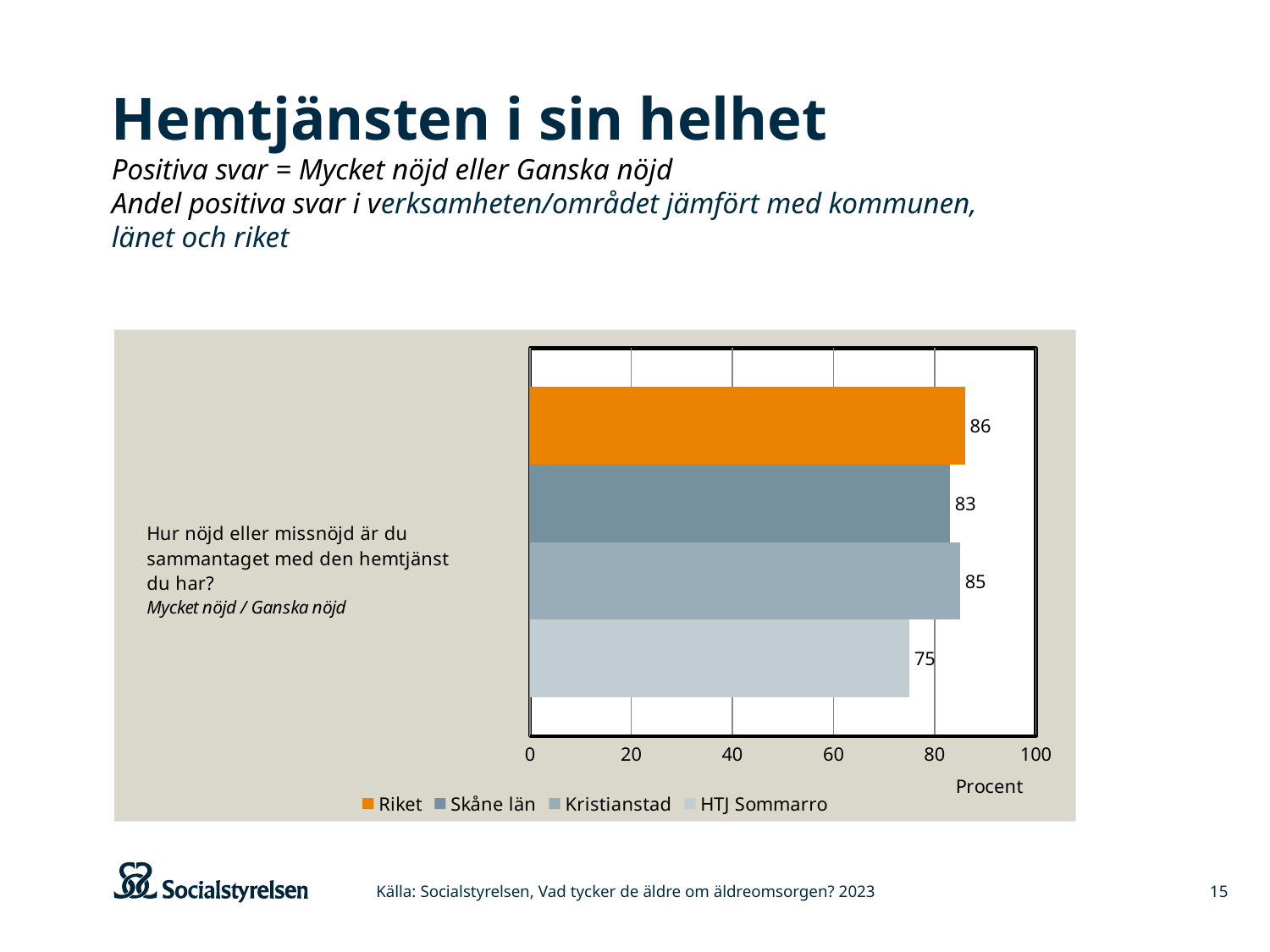
What is the value for Riket? 86 How many series does the legend list? 4 What is the value for HTJ Sommarro? 75 What is the value for Skåne län? 83 Which is larger, the value for Kristianstad or the value for HTJ Sommarro? Kristianstad What kind of chart is shown on the slide? Bar chart What is the difference between the values for Kristianstad and Skåne län? 2 What is the difference between the values for Riket and HTJ Sommarro? 11 What is the value for Kristianstad? 85 Which series has the highest value? Riket Which series has the lowest value? HTJ Sommarro What is the label of the horizontal axis? Procent